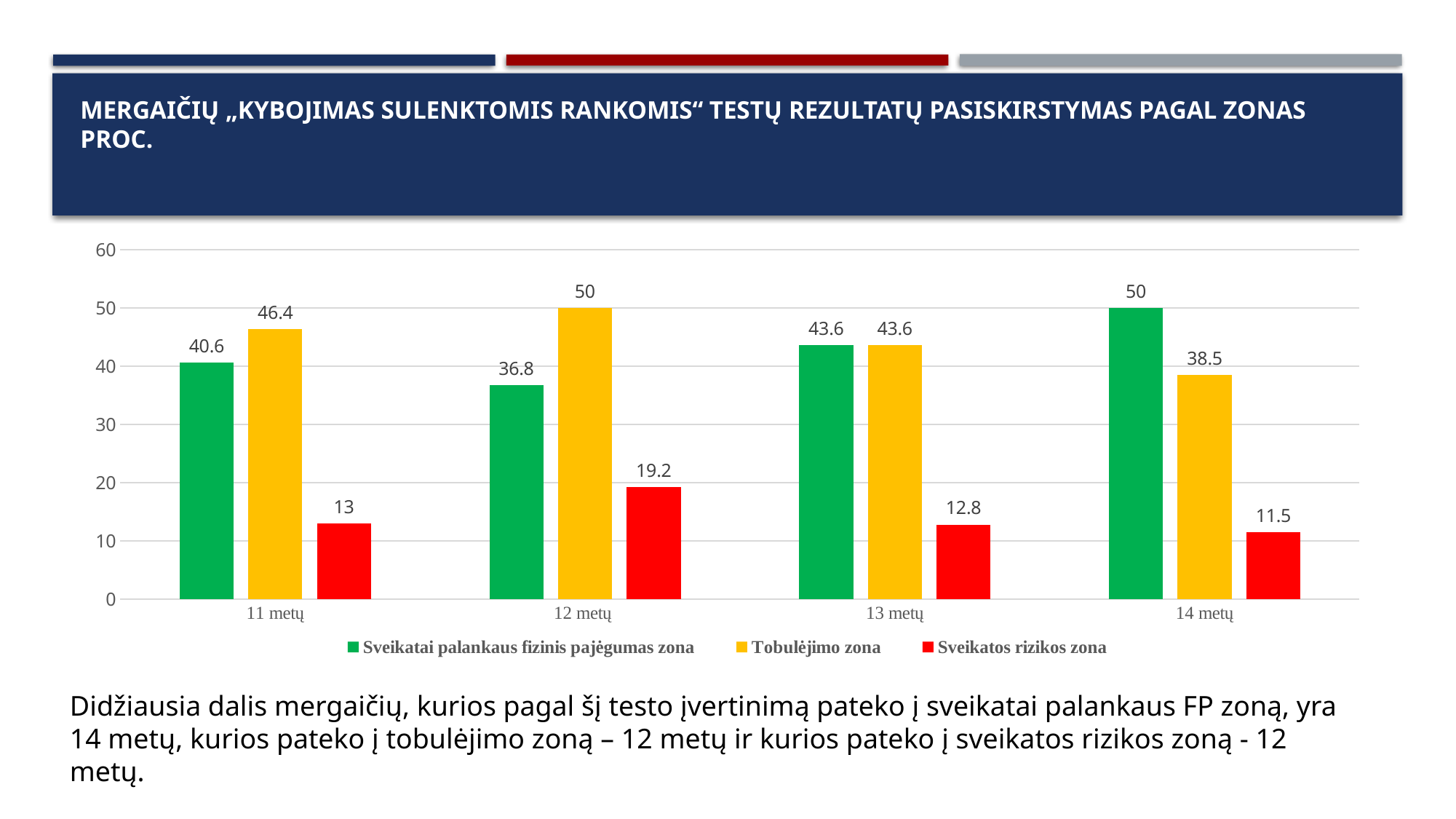
Which colour represents "Sveikatos rizikos zona" in the chart? red Which is larger at 12 metų: "Sveikatai palankaus fizinis pajėgumas zona" or "Tobulėjimo zona"? Tobulėjimo zona What kind of chart is shown on the slide? bar chart How many age groups are shown on the x axis? 4 What is the difference between the "Tobulėjimo zona" values at 12 metų and 14 metų? 11.5 What is the value for "Tobulėjimo zona" at 12 metų? 50 Which age group has the lowest value for "Sveikatos rizikos zona"? 14 metų What is the value for "Sveikatos rizikos zona" at 14 metų? 11.5 What is the value for "Sveikatai palankaus fizinis pajėgumas zona" at 11 metų? 40.6 Which age group has the highest value for "Sveikatai palankaus fizinis pajėgumas zona"? 14 metų Is the value for "Sveikatos rizikos zona" at 12 metų greater or less than 20? less How many series does the legend list? 3